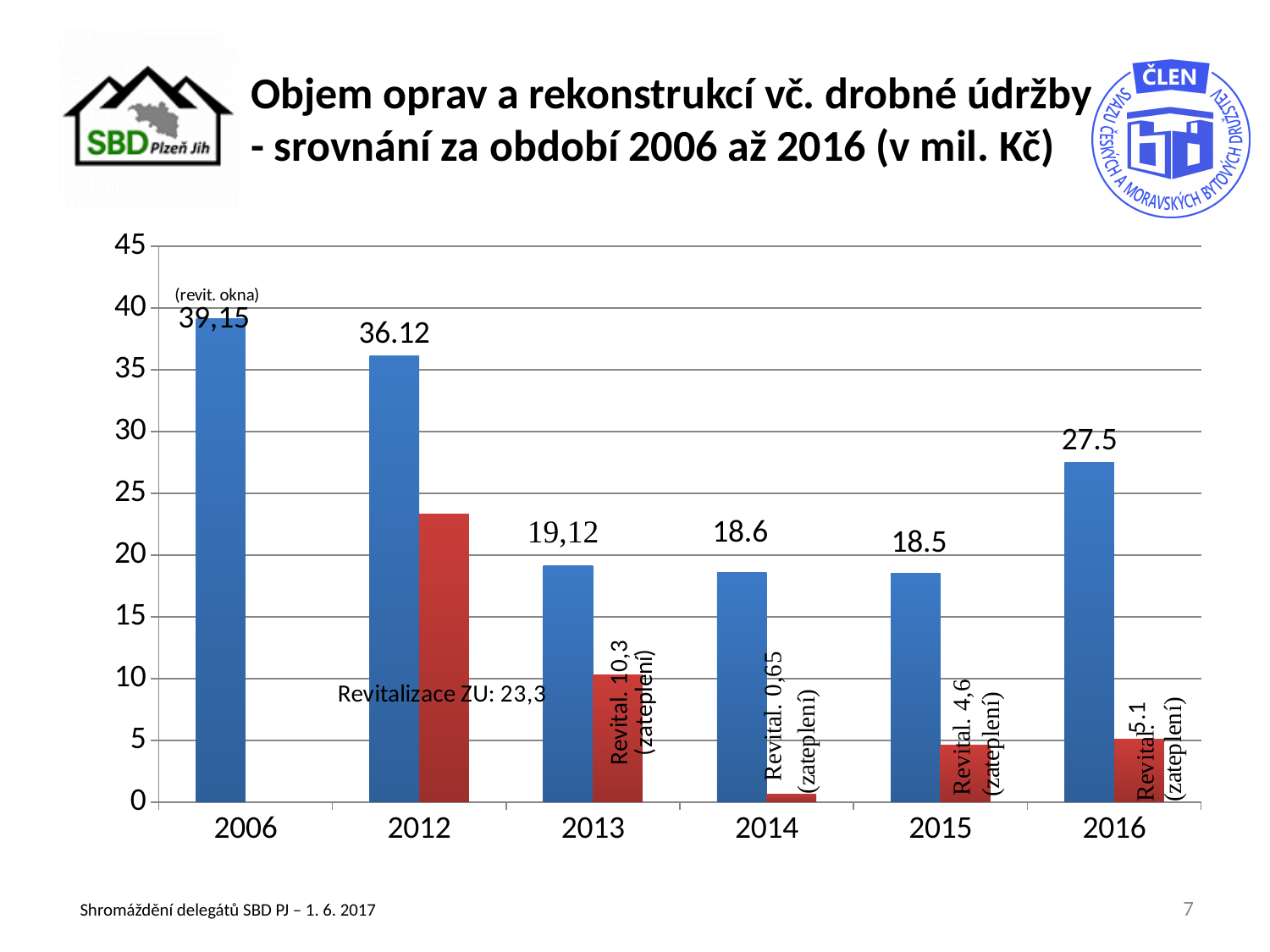
Which year has a larger blue bar, 2013 or 2016? 2016 What is the value of the blue bar for 2006? 39,15 Which year has the highest blue bar? 2006 What is the value labelled 'Revitalizace ZU' for 2012? 23,3 What revitalization (Revital.) value is labelled for 2013? 10,3 What is the value of the blue bar for 2016? 27.5 What is the difference between the blue bar values for 2016 and 2015? 9 Which year has the lowest red (Revital.) bar? 2014 What kind of chart is shown on the slide? bar chart How many years are shown on the x axis? 6 Is the value of the red bar for 2012 greater or less than 20? greater What is the value of the blue bar for 2012? 36.12